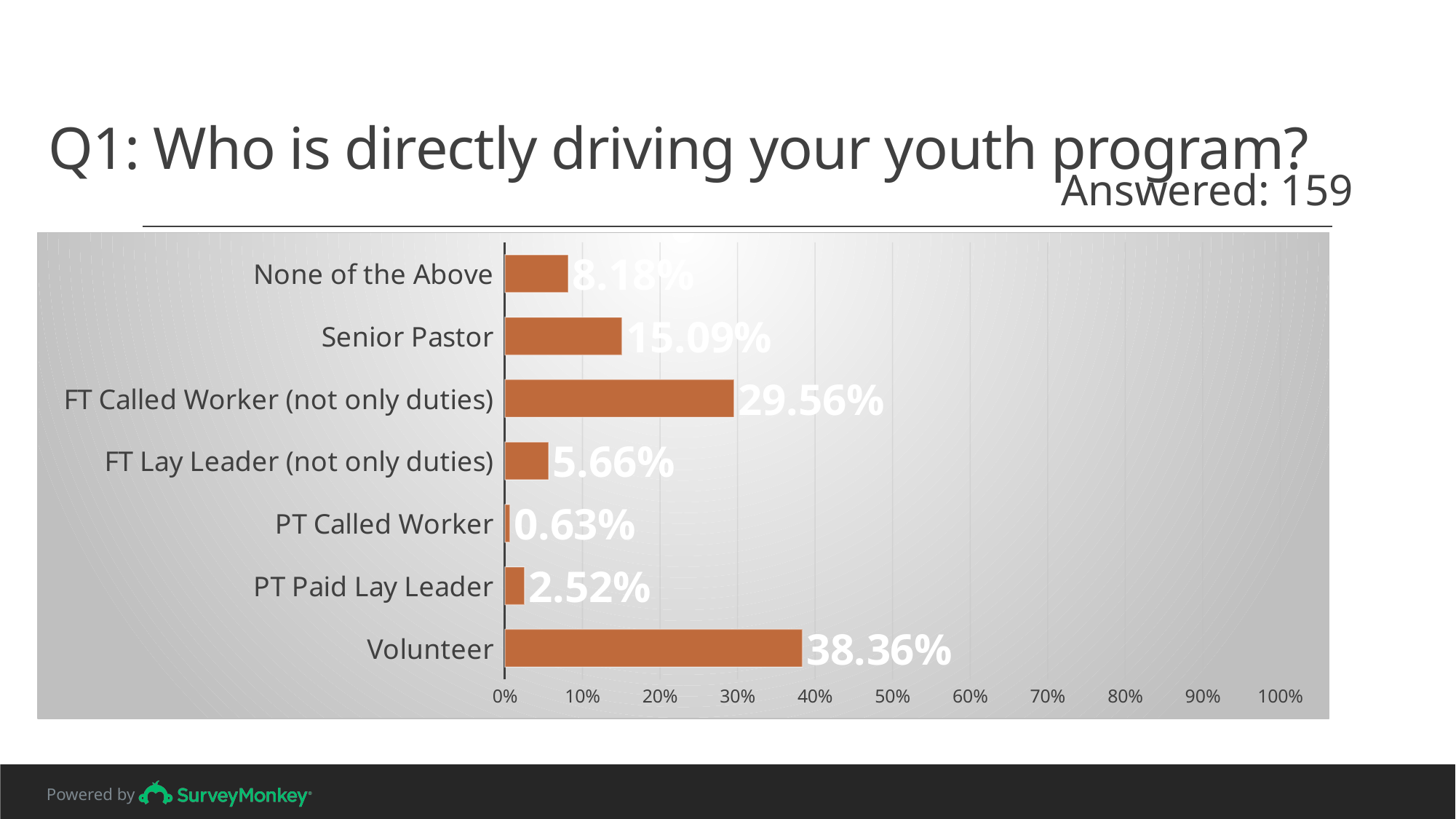
What percentage is shown for Senior Pastor? 15.09% Which category has the lowest percentage? PT Called Worker Which category has the highest percentage? Volunteer What percentage is shown for PT Called Worker? 0.63% What is the difference between the Volunteer and FT Called Worker (not only duties) percentages? 8.80% How many categories are shown in the chart? 7 How many respondents answered the question, according to the slide? 159 What percentage is shown for Volunteer? 38.36% Which is larger, the value for Senior Pastor or the value for None of the Above? Senior Pastor What percentage is shown for FT Called Worker (not only duties)? 29.56% Is the value for FT Called Worker (not only duties) greater or less than 20%? greater What kind of chart is shown on the slide? Bar chart